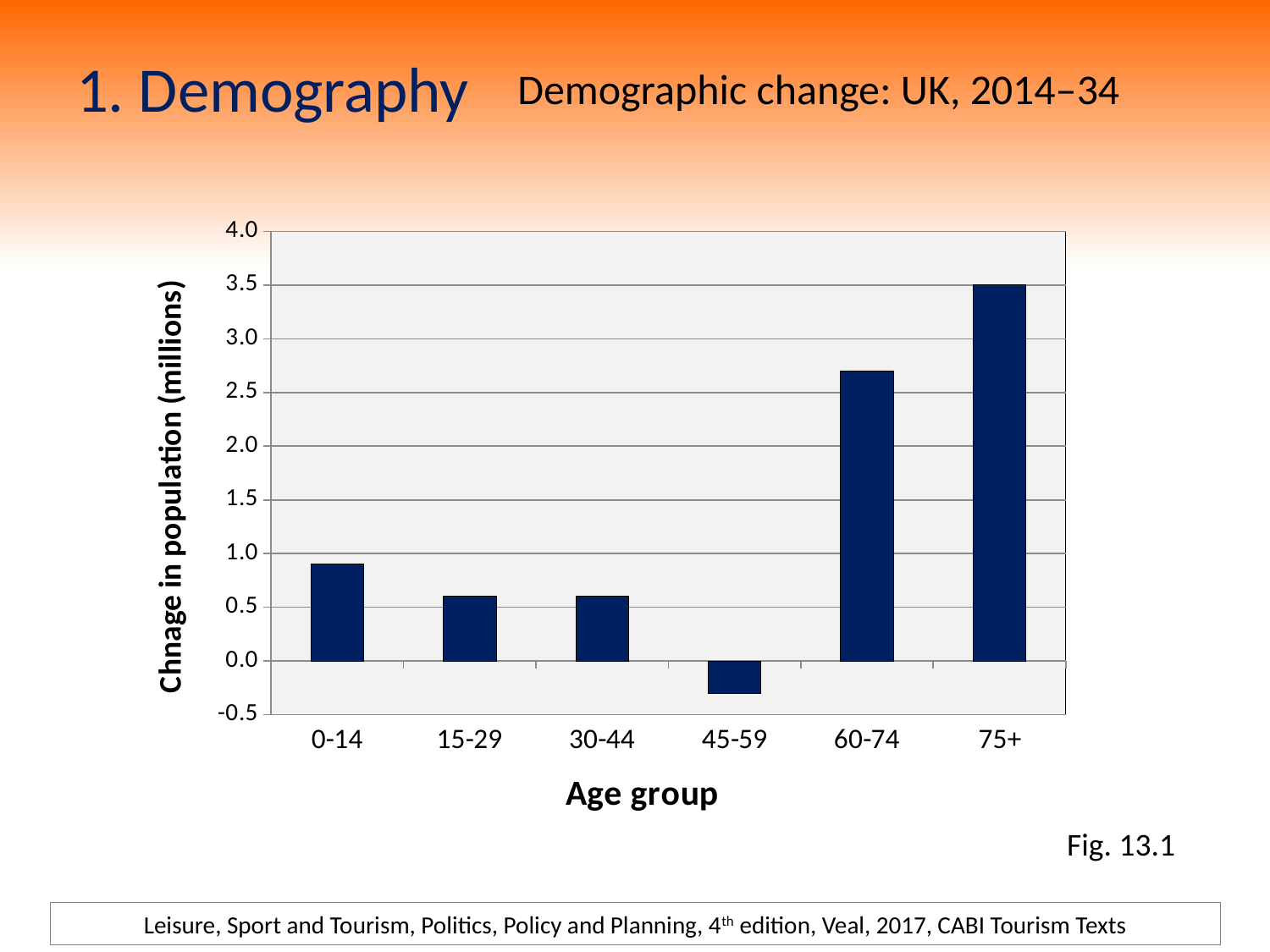
Is the value for the 0-14 age group greater or less than 1.0? less Which age group has a larger change in population, 0-14 or 15-29? 0-14 What is the change in population (millions) for the 75+ age group? 3.5 What kind of chart is shown on the slide? Bar chart What is the title of the chart? Demographic change: UK, 2014–34 Is the value for the 60-74 age group greater or less than 2.5? greater Is the value for the 15-29 age group greater or less than 0.5? greater Which age group has a larger change in population, 60-74 or 75+? 75+ How many age groups are shown on the x axis of the chart? 6 Which age group has the lowest change in population? 45-59 Which age group has the highest change in population? 75+